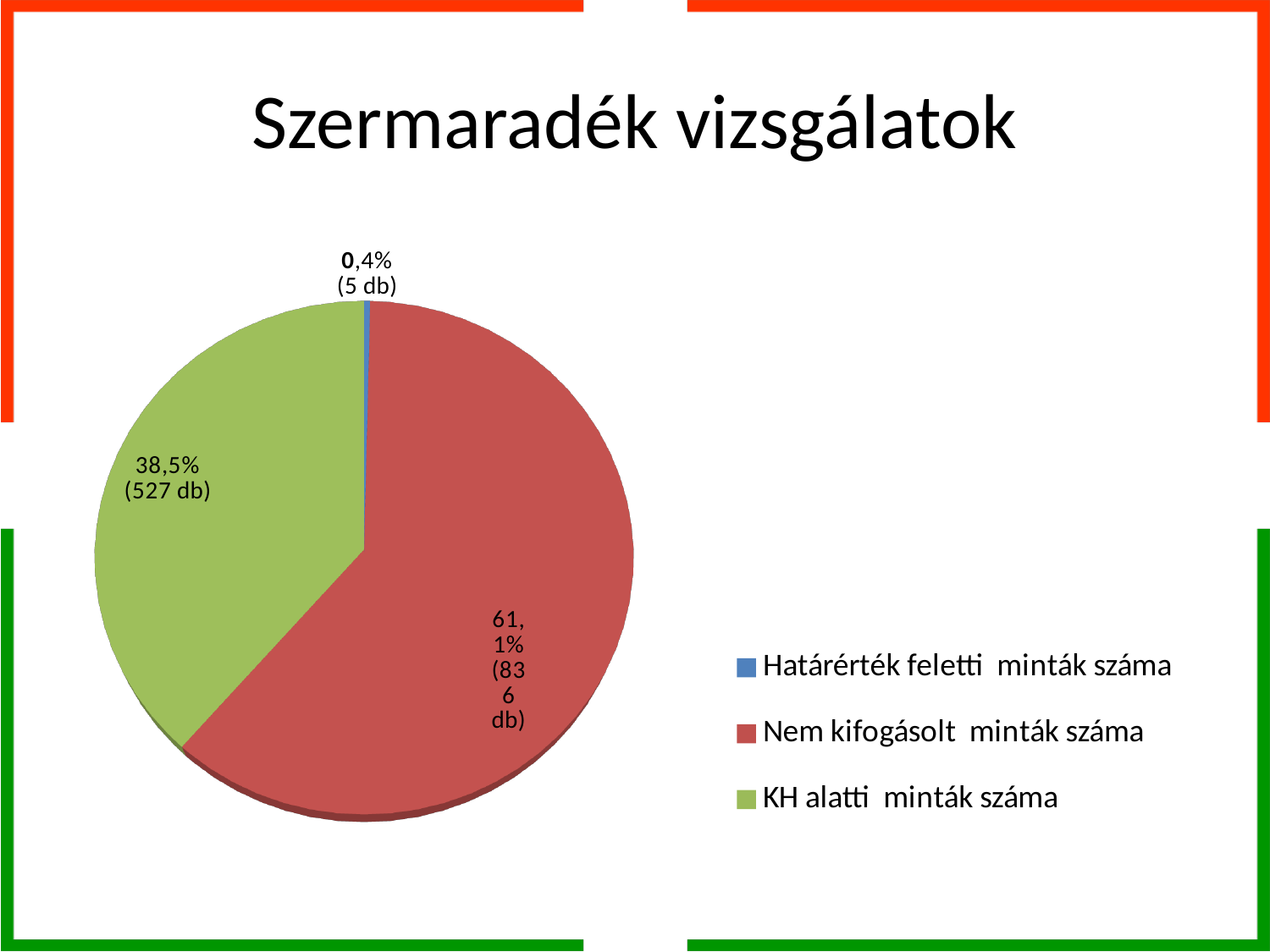
How many samples (db) are in the 'KH alatti minták száma' slice? 527 db What is the title of the chart? Szermaradék vizsgálatok How many entries does the legend list? 3 Which colour represents 'KH alatti minták száma' in the chart? green How many slices does the pie chart have? 3 What percentage share does the 'Határérték feletti minták száma' slice have? 0,4% Which category has the smallest slice of the pie? Határérték feletti minták száma Which category has the largest slice of the pie? Nem kifogásolt minták száma How many samples (db) are in the 'Határérték feletti minták száma' slice? 5 db What kind of chart is shown on the slide? pie chart What percentage share does the 'KH alatti minták száma' slice have? 38,5% What percentage share does the 'Nem kifogásolt minták száma' slice have? 61,1%